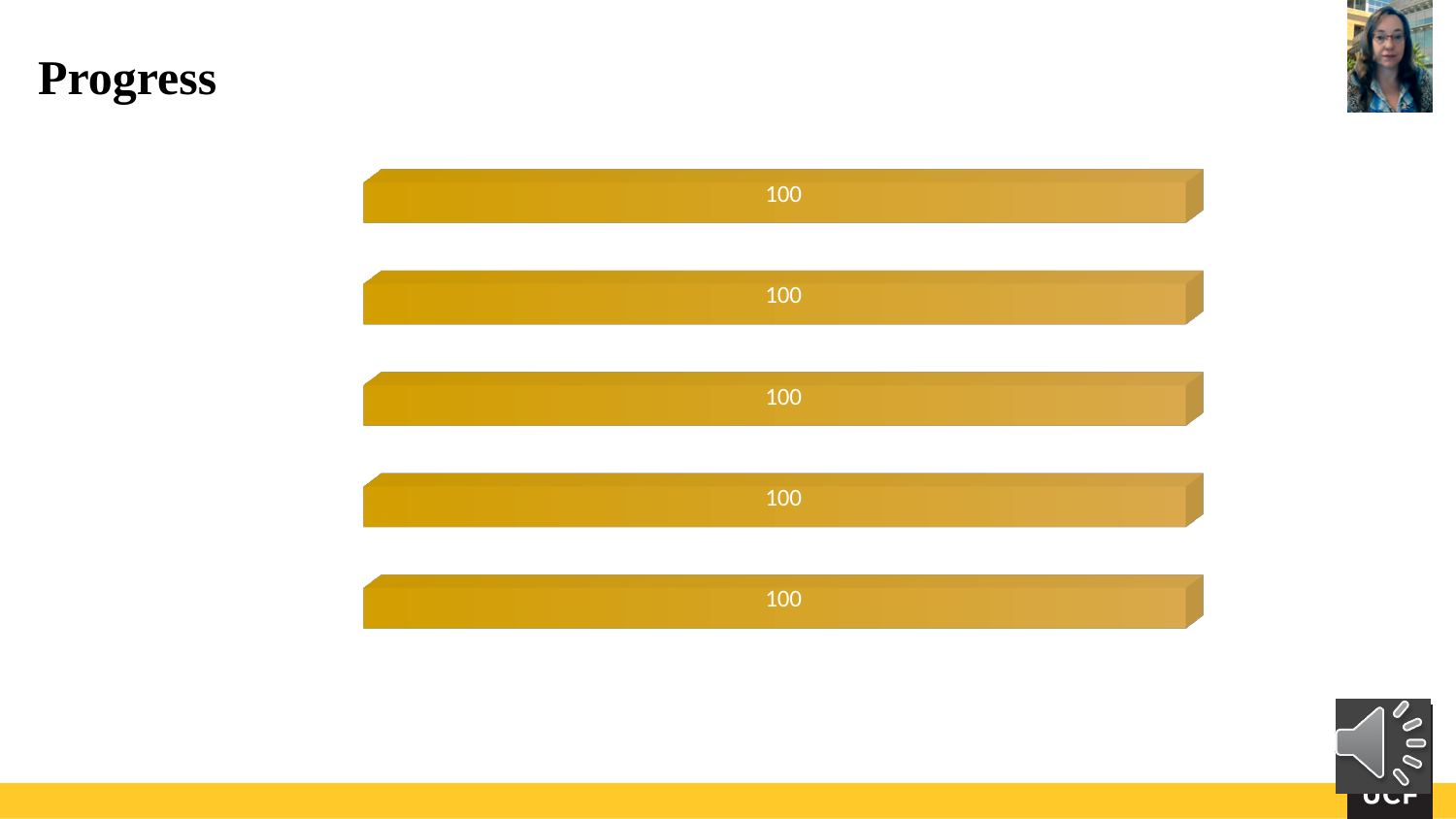
What kind of chart is shown on the slide? bar chart Do the bar values change from the top bar to the bottom bar, or stay the same? stay the same What is the value shown on the top bar of the chart? 100 What is the value shown on the middle (third) bar of the chart? 100 How many bars does the chart show? 5 What colour are the bars in the chart? gold What is the title of the slide containing the chart? Progress What is the value shown on the bottom bar of the chart? 100 Is the value of the second bar from the top greater or less than 50? greater What is the difference between the value of the top bar and the value of the bottom bar? 0